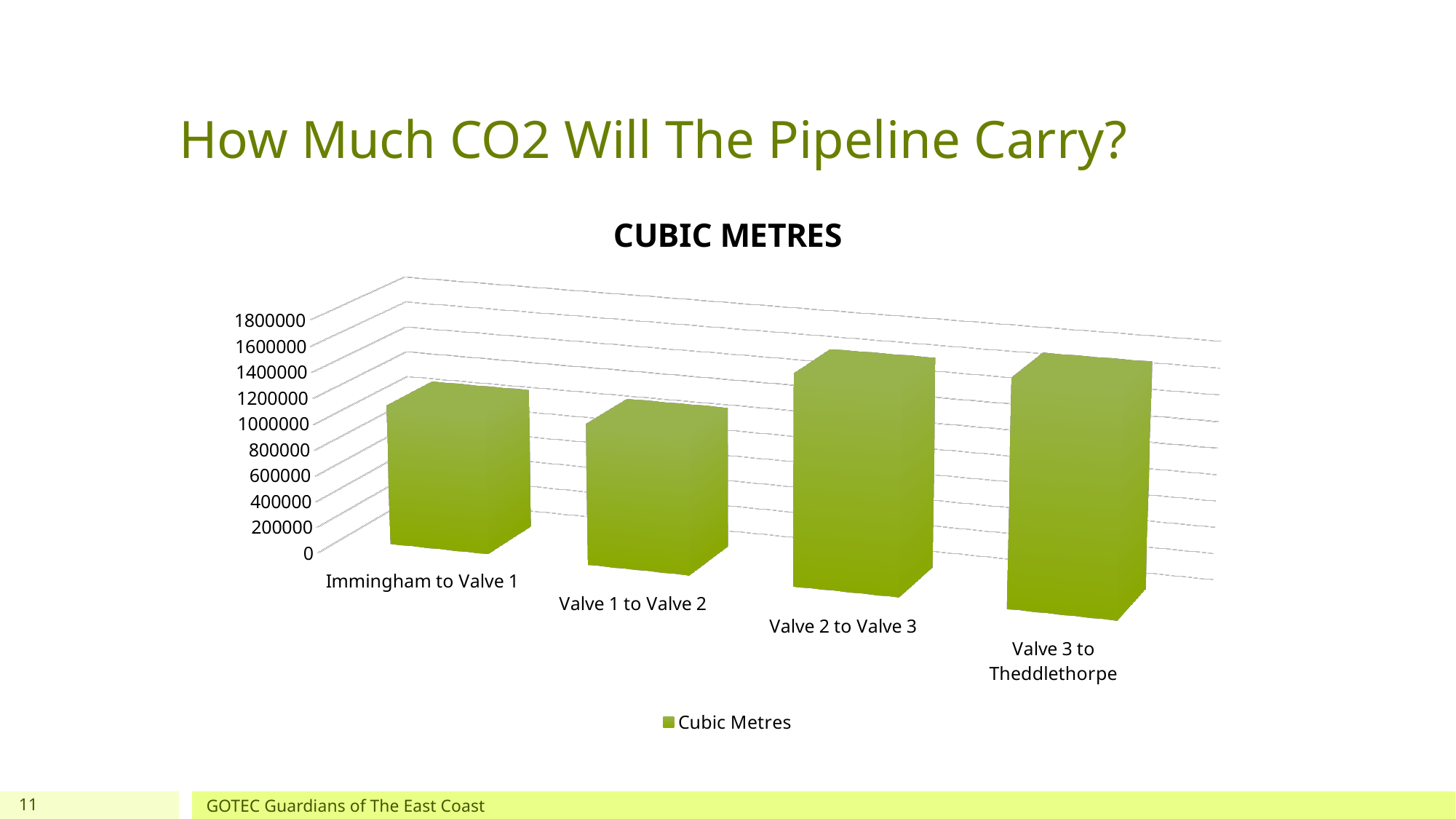
Which is larger, the value for Valve 3 to Theddlethorpe or the value for Immingham to Valve 1? Valve 3 to Theddlethorpe Is the value for Immingham to Valve 1 greater or less than 1400000? less Is the value for Immingham to Valve 1 greater or less than 800000? greater How many series does the chart legend list? 1 How many categories (pipeline sections) are shown on the chart? 4 What type of chart is shown on the slide? bar chart What is the name of the series shown in the legend? Cubic Metres What is the title of the chart? CUBIC METRES Is the value for Valve 2 to Valve 3 greater or less than 1000000? greater Which is larger, the value for Valve 2 to Valve 3 or the value for Valve 1 to Valve 2? Valve 2 to Valve 3